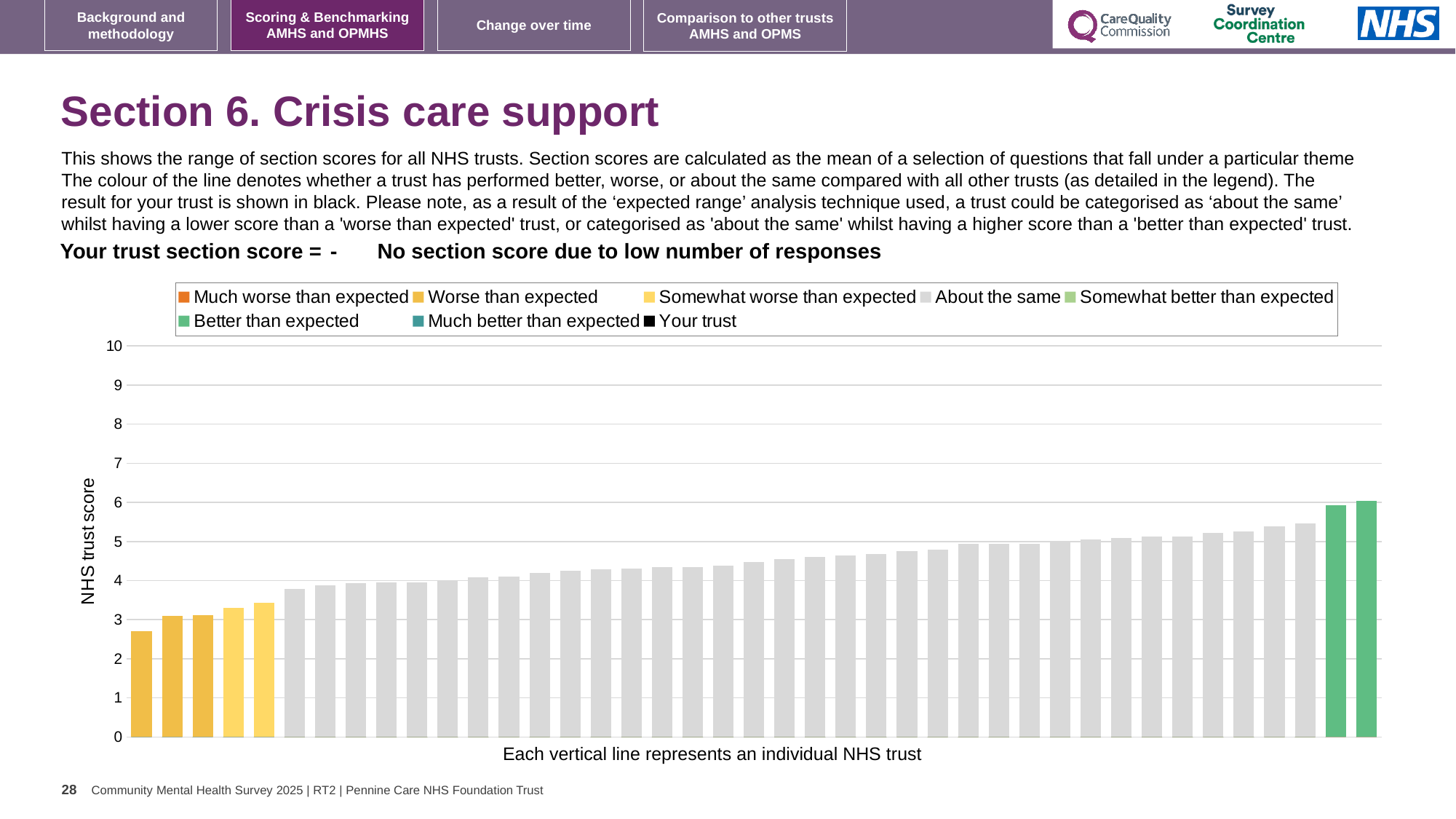
Is the value of the leftmost (lowest) bar greater or less than 3? less What kind of chart is shown on the slide? bar chart What is the label on the vertical axis of the chart? NHS trust score How many bars are coloured in the darker yellow 'Worse than expected' colour? 3 How many entries does the chart legend list? 8 Is the value of the tallest bar greater or less than 7? less Do the bar values rise or fall from left to right across the chart? rise Is the value of the leftmost (lowest) bar greater or less than 2? greater How many bars are coloured green (better than expected)? 2 Which legend category do the tallest bars in the chart belong to? Better than expected How many bars are coloured in the lighter yellow 'Somewhat worse than expected' colour? 2